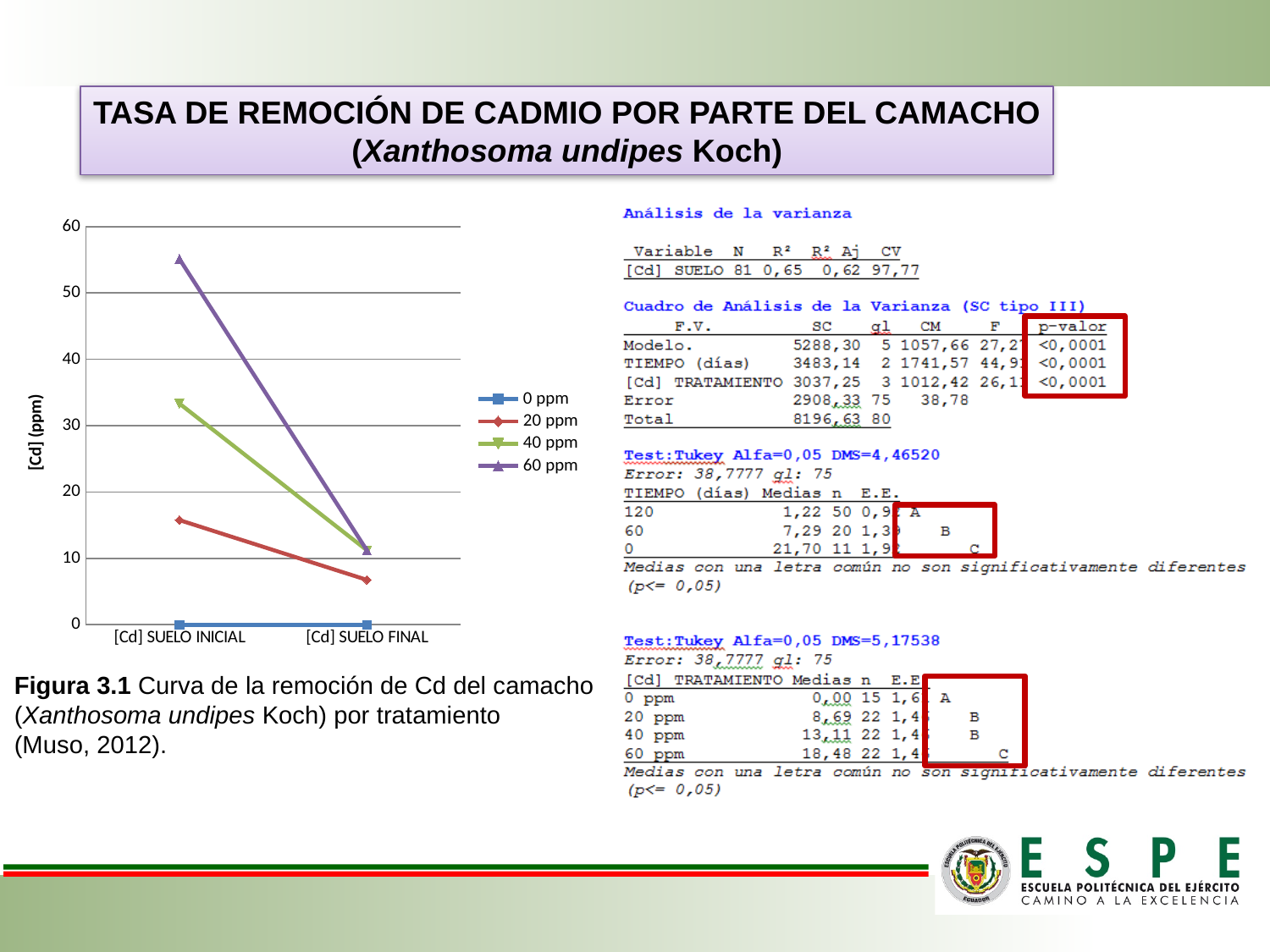
Is the value of the 20 ppm series at [Cd] SUELO FINAL greater or less than 10? less Is the value of the 20 ppm series at [Cd] SUELO INICIAL greater or less than 20? less Which series has the highest value at [Cd] SUELO INICIAL? 60 ppm How many series does the legend of the chart list? 4 Does the 60 ppm series rise or fall from [Cd] SUELO INICIAL to [Cd] SUELO FINAL? fall What kind of chart is shown on the left of the slide? line chart What is the label of the y axis of the chart? [Cd] (ppm) Is the value of the 40 ppm series at [Cd] SUELO INICIAL greater or less than 30? greater Which series has the lowest value at [Cd] SUELO INICIAL? 0 ppm At [Cd] SUELO INICIAL, which is larger: the 60 ppm series or the 40 ppm series? 60 ppm How many categories are shown on the x axis of the chart? 2